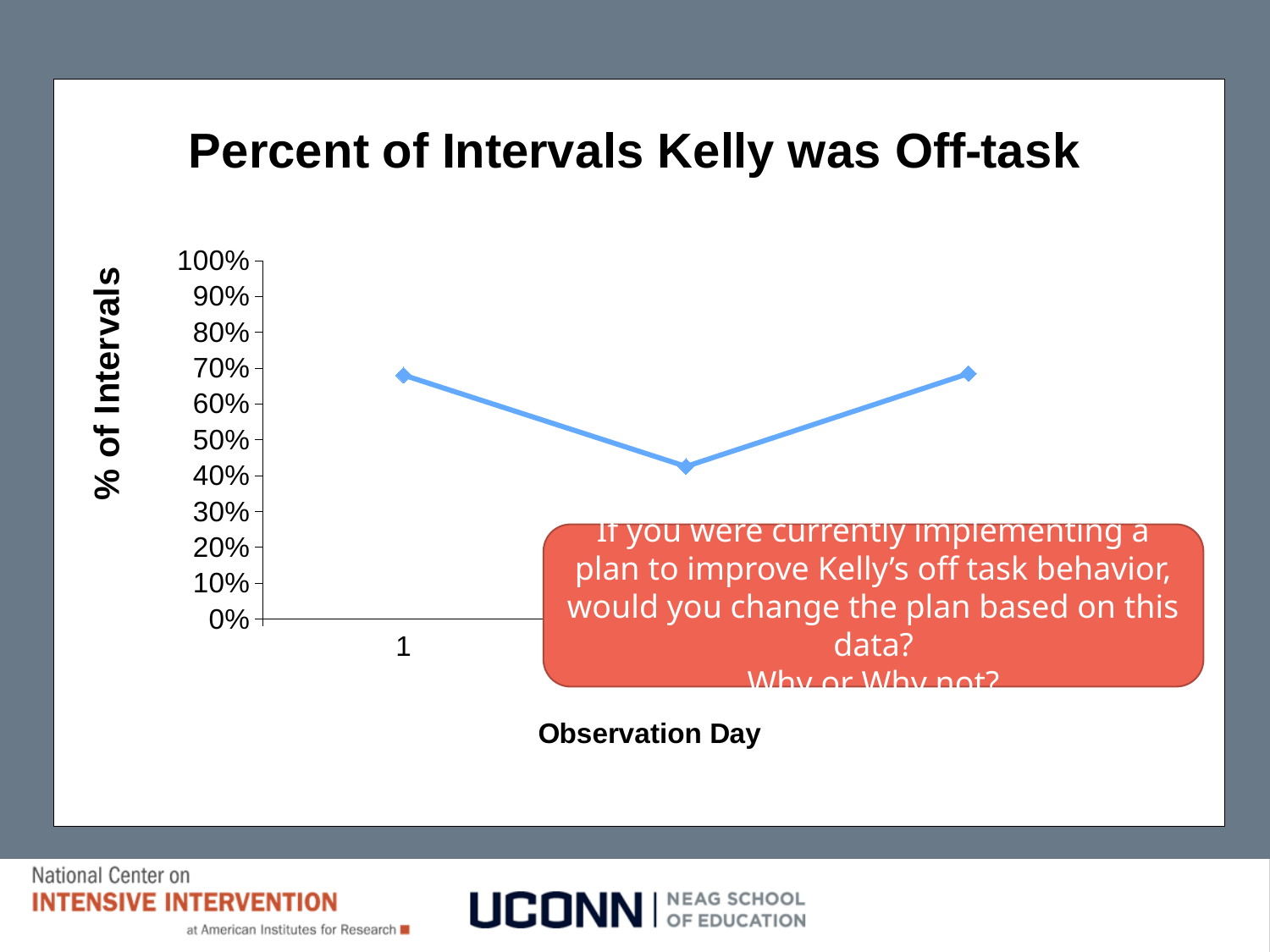
Is the value for Observation Day 1 greater or less than 60%? greater Does the line rise or fall from the middle point to the last point? rise Which is larger: the value for Observation Day 1 or the value at the middle point of the line? Observation Day 1 What is the title of the chart? Percent of Intervals Kelly was Off-task What kind of chart is shown on the slide? line chart Does the line rise or fall from the first point to the middle point? fall Is the last point on the line greater or less than 60%? greater Is the lowest point on the line greater or less than 50%? less What is the label on the y axis of the chart? % of Intervals How many data points are plotted on the line? 3